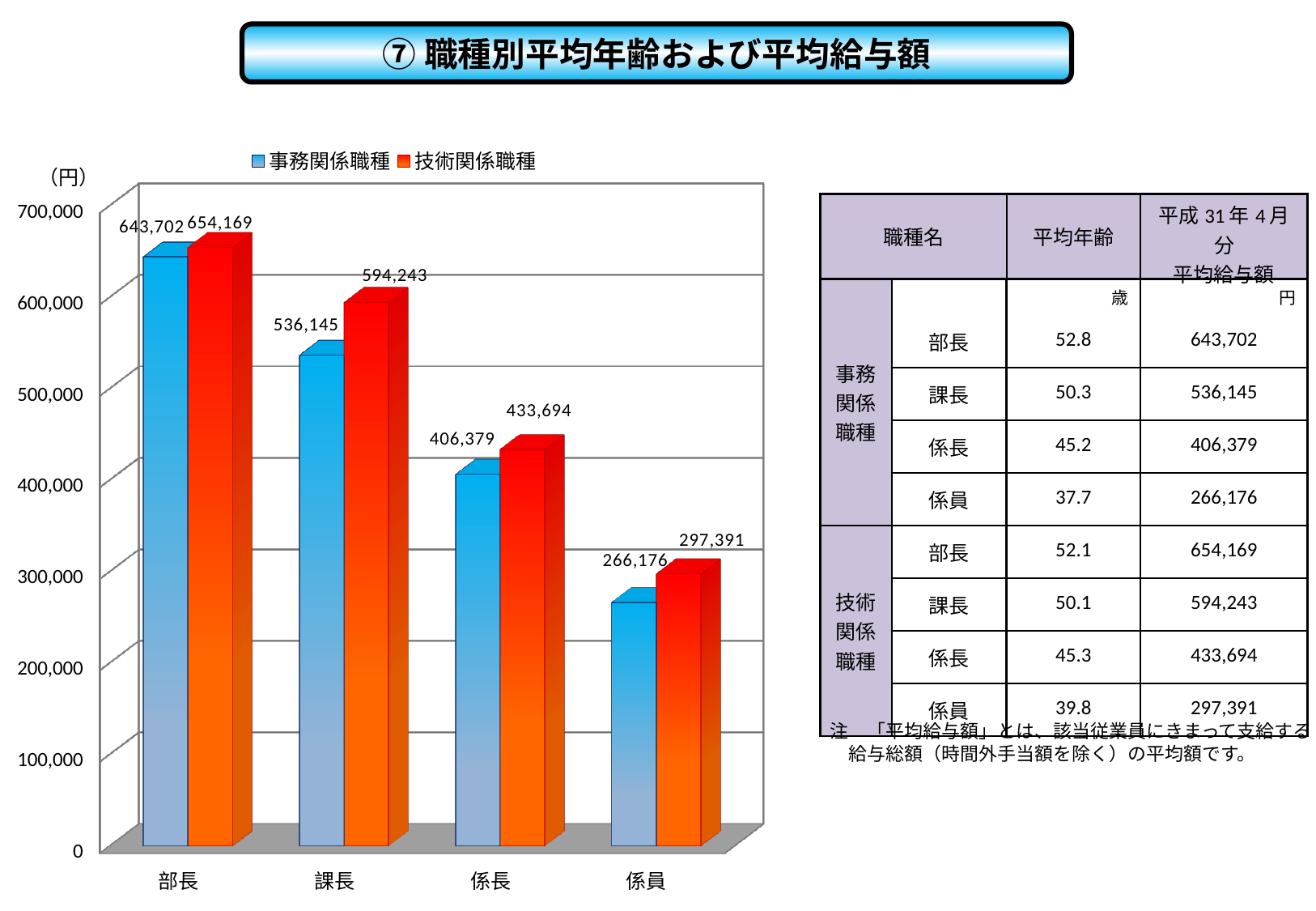
Which category has the lowest value for 事務関係職種? 係員 What is the difference between 技術関係職種 and 事務関係職種 in the 係長 category? 27,315 What is the value for 事務関係職種 in the 係員 category? 266,176 Do the values for 技術関係職種 rise or fall from 部長 to 係員 along the x axis? fall What is the value for 事務関係職種 in the 部長 category? 643,702 What kind of chart is shown on the slide? bar chart How many categories are shown on the x axis? 4 What is the value for 技術関係職種 in the 課長 category? 594,243 Which category has the highest value for 技術関係職種? 部長 How many series does the legend list? 2 Which is larger in the 係員 category, 事務関係職種 or 技術関係職種? 技術関係職種 Is the value for 事務関係職種 in the 課長 category greater or less than 500,000? greater